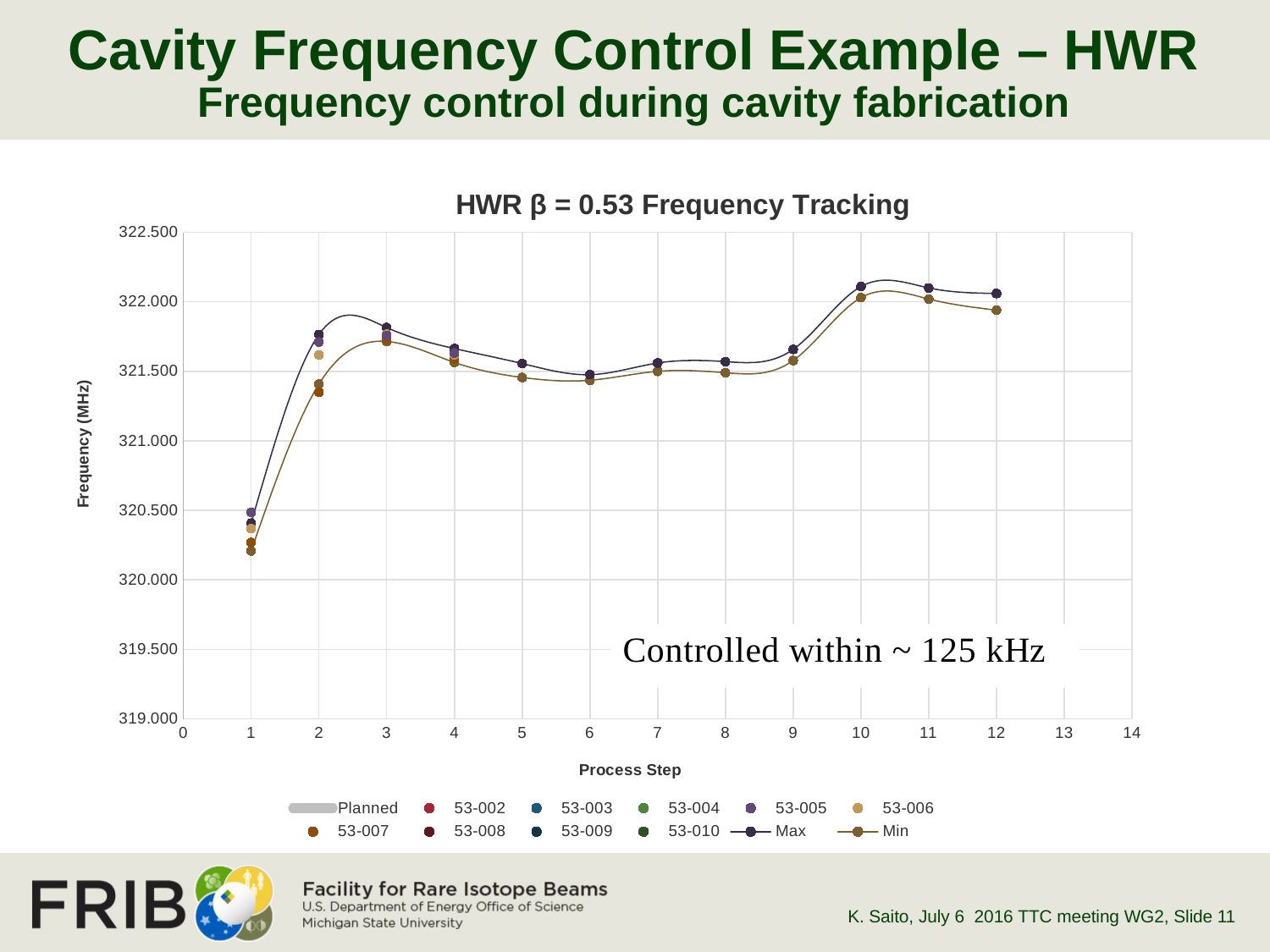
Is the Max value larger at process step 2 or at process step 1? process step 2 What is the label of the y-axis? Frequency (MHz) Is the Max value at process step 10 greater or less than 322.000? greater Is the Max value at process step 3 greater or less than 321.500? greater Is the Min value at process step 1 greater or less than 320.500? less At which process step is the frequency lowest? 1 How many process steps have data points plotted on the chart? 12 Do the frequency values rise or fall from process step 9 to process step 10? rise Does the Max line rise or fall from process step 3 to process step 6? fall What is the title of the chart? HWR β = 0.53 Frequency Tracking How many series does the chart legend list? 12